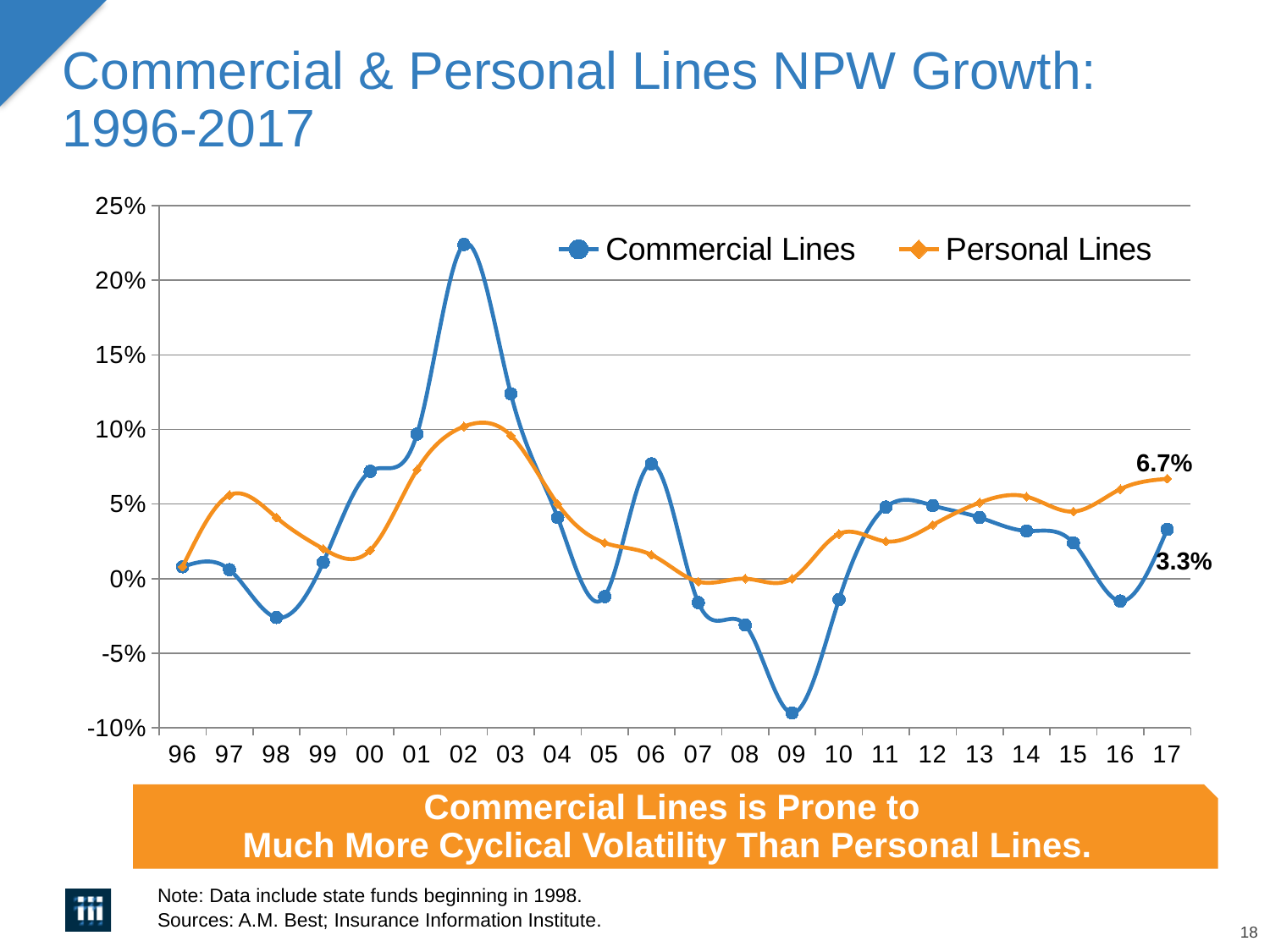
Is the value for Commercial Lines in 09 greater or less than -5%? less What is the value for Personal Lines in 17? 6.7% Does the Commercial Lines value rise or fall from 02 to 05? Fall What kind of chart is shown on the slide? Line chart What is the difference between the Personal Lines and Commercial Lines values in 17? 3.4 percentage points What is the value for Commercial Lines in 17? 3.3% Is the value for Personal Lines in 02 greater or less than 5%? greater How many series does the legend list? 2 In which year does Commercial Lines reach its lowest value? 09 In which year does Commercial Lines reach its highest value? 02 In 17, which series has the larger value, Commercial Lines or Personal Lines? Personal Lines Is the value for Commercial Lines in 02 greater or less than 20%? greater